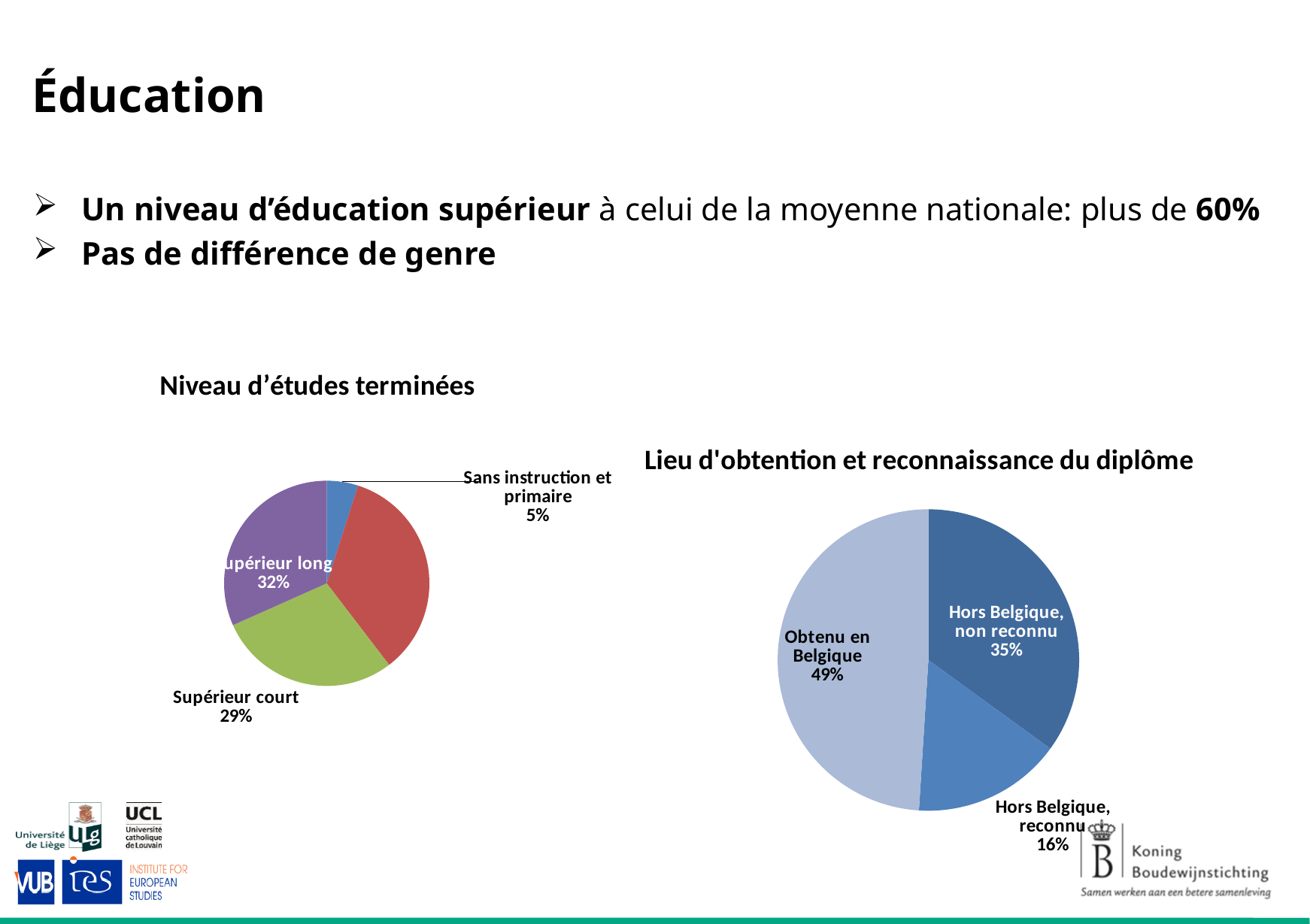
How many slices does the 'Niveau d'études terminées' pie chart have? 4 In the 'Niveau d'études terminées' chart, what is the difference between 'Supérieur long' and 'Supérieur court'? 3% In the 'Niveau d'études terminées' chart, which labelled category has the smallest share? Sans instruction et primaire In the 'Lieu d'obtention et reconnaissance du diplôme' chart, which category has the largest share? Obtenu en Belgique In the 'Niveau d'études terminées' chart, what share is 'Sans instruction et primaire'? 5% In the 'Niveau d'études terminées' chart, what share is 'Supérieur court'? 29% In the 'Niveau d'études terminées' chart, what share is 'Supérieur long'? 32% In the 'Niveau d'études terminées' chart, which is larger: 'Supérieur long' or 'Supérieur court'? Supérieur long In the 'Lieu d'obtention et reconnaissance du diplôme' chart, what is the difference between 'Hors Belgique, non reconnu' and 'Hors Belgique, reconnu'? 19% In the 'Lieu d'obtention et reconnaissance du diplôme' chart, what share is 'Obtenu en Belgique'? 49% In the 'Lieu d'obtention et reconnaissance du diplôme' chart, what share is 'Hors Belgique, reconnu'? 16% What kind of chart is 'Niveau d'études terminées'? Pie chart